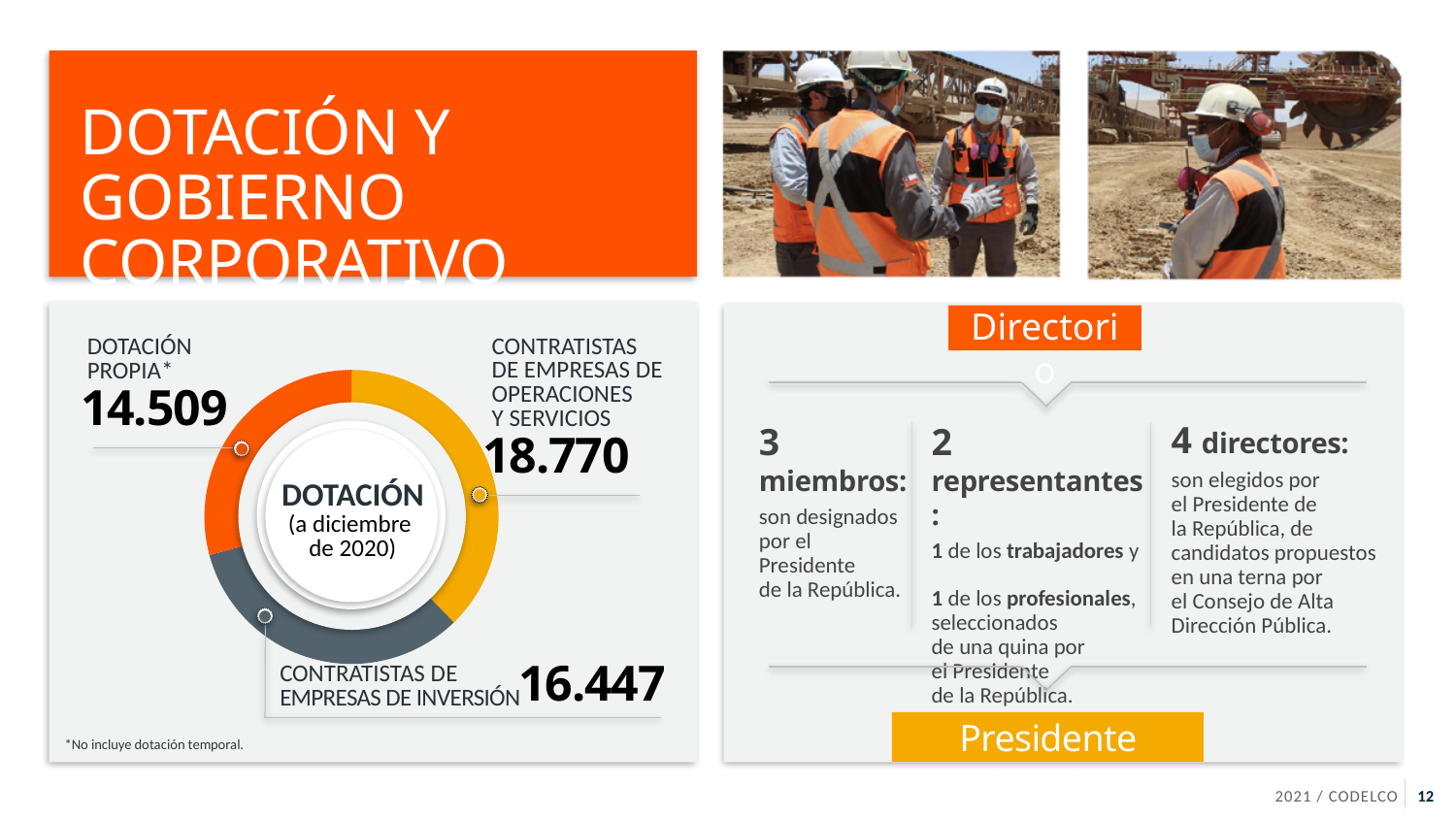
What is the total of all three categories in the Dotación chart? 49.726 What is the difference between Contratistas de empresas de operaciones y servicios and Dotación propia in the Dotación chart? 4.261 How many categories does the Dotación chart show? 3 What is the value for Dotación propia in the Dotación chart? 14.509 Which is larger in the Dotación chart: Contratistas de empresas de inversión or Dotación propia? Contratistas de empresas de inversión As of what date is the Dotación chart reported, according to its centre label? Diciembre de 2020 What kind of chart is shown on the left of the slide? Donut (pie) chart What is the value for Contratistas de empresas de inversión in the Dotación chart? 16.447 What is the value for Contratistas de empresas de operaciones y servicios in the Dotación chart? 18.770 Which category has the highest value in the Dotación chart? Contratistas de empresas de operaciones y servicios What is the difference between Contratistas de empresas de inversión and Dotación propia in the Dotación chart? 1.938 Which category has the lowest value in the Dotación chart? Dotación propia